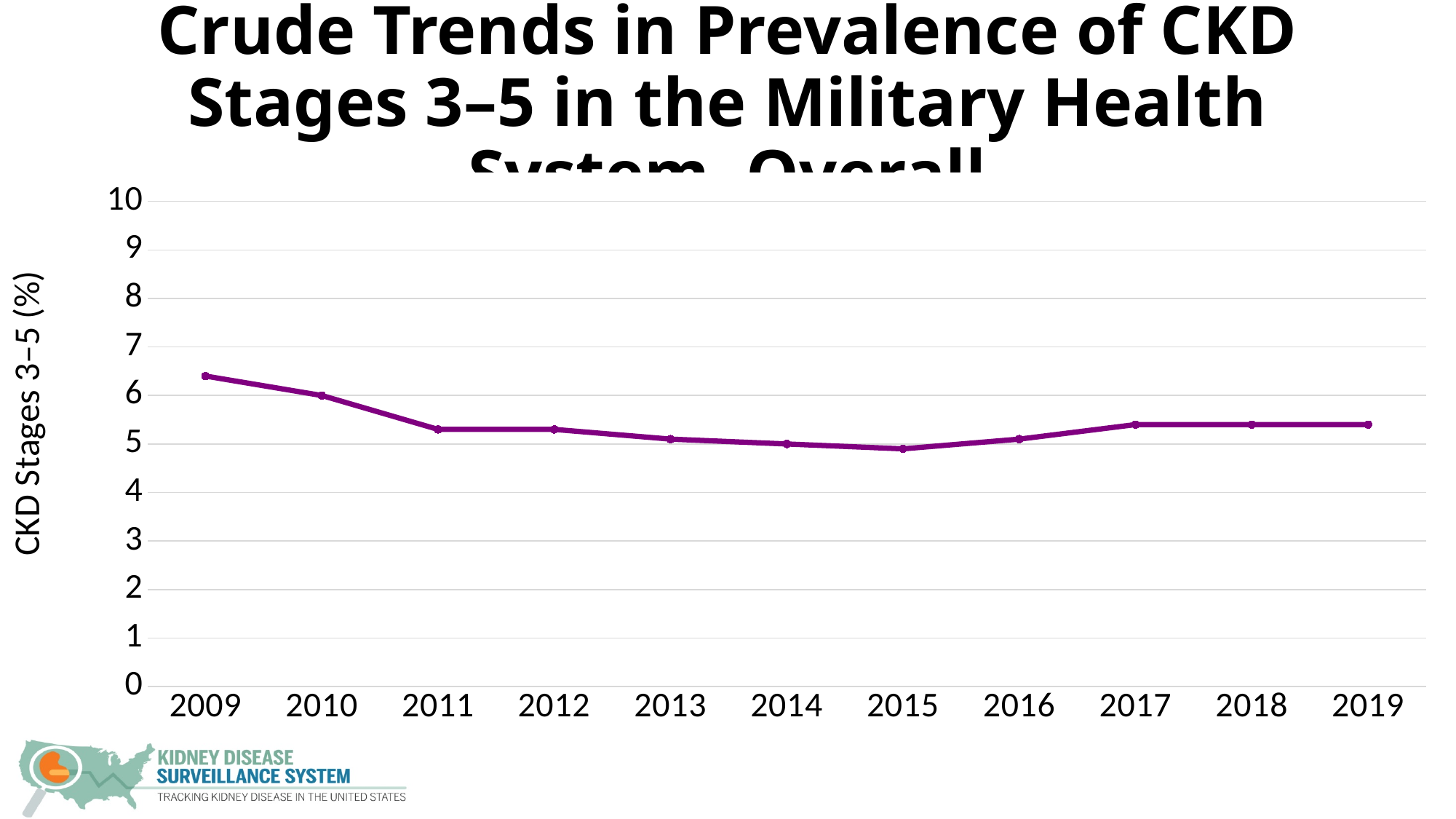
What is the label on the y axis? CKD Stages 3–5 (%) Which is larger, the value for 2009 or the value for 2019? 2009 Which is larger, the value for 2010 or the value for 2015? 2010 Is the value for 2009 greater or less than 6? greater Is the value for 2011 greater or less than 5? greater Which year has the highest CKD Stages 3–5 prevalence? 2009 How many years are plotted along the x axis? 11 Is the value for 2013 greater or less than 6? less Does the prevalence rise or fall from 2009 to 2015? fall What kind of chart is shown on the slide? line chart